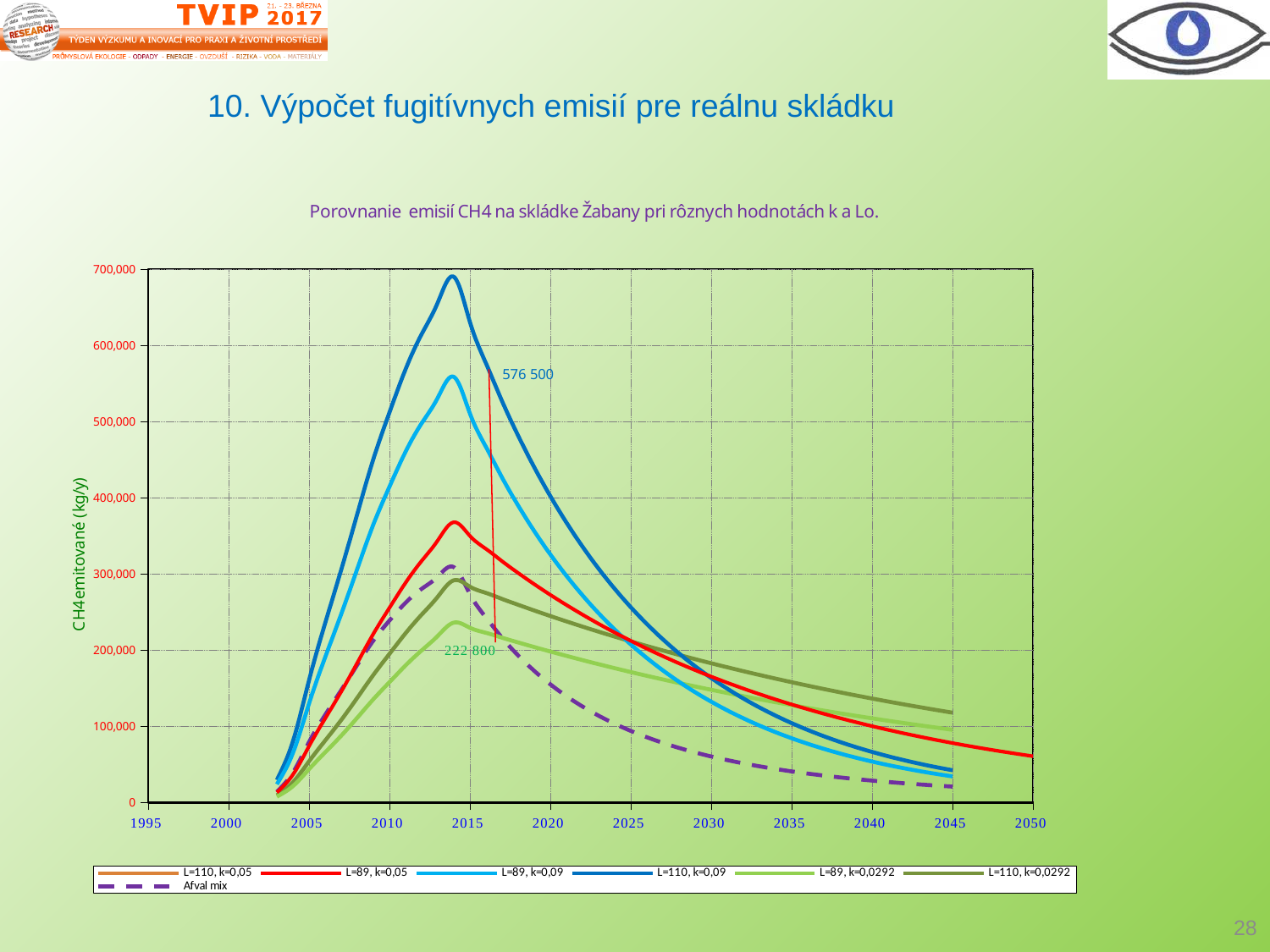
Is the peak value of the L=89, k=0,05 series greater or less than 400,000? less Is the peak value of the L=110, k=0,09 series greater or less than 600,000? greater Is the peak value of the L=89, k=0,09 series greater or less than 600,000? less What kind of chart is shown on the slide? line chart How many series does the legend list? 7 What is the title of the chart? Porovnanie emisií CH4 na skládke Žabany pri rôznych hodnotách k a Lo. At 2045, which series is higher: L=110, k=0,0292 or Afval mix? L=110, k=0,0292 What is the label of the y axis? CH4 emitované (kg/y) Which two values are annotated on the chart near the year 2016? 576 500 and 222 800 Do the values of the series rise or fall along the x axis after 2015? fall Which series reaches the highest peak value? L=110, k=0,09